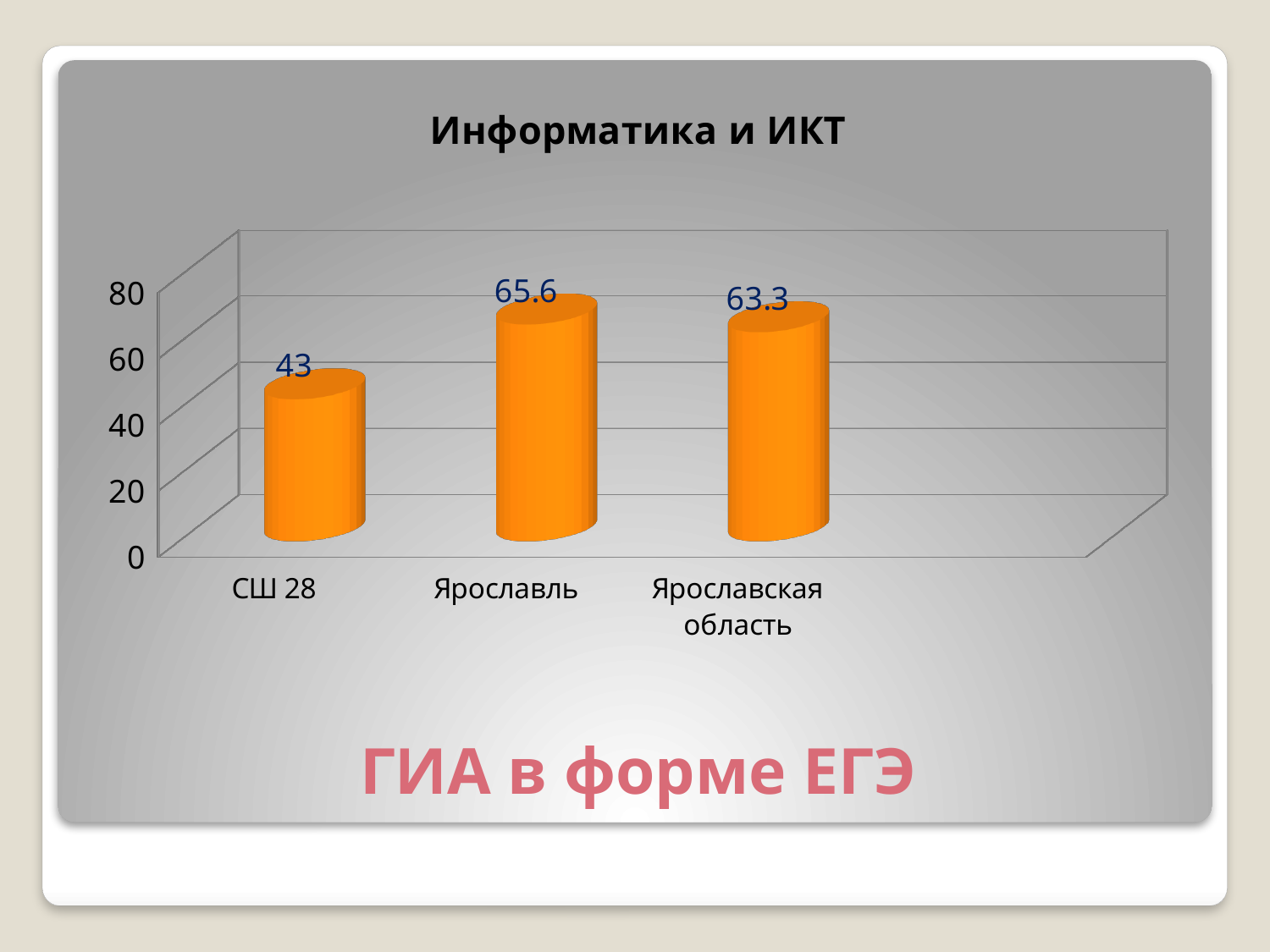
How many categories are shown on the x axis? 3 What is the difference between the values for Ярославль and Ярославская область? 2.3 Is the value for СШ 28 greater or less than 60? less What is the value for Ярославская область? 63.3 What is the value for Ярославль? 65.6 What is the value for СШ 28? 43 What kind of chart is shown on the slide? bar chart Which is larger, the value for Ярославская область or the value for СШ 28? Ярославская область What is the difference between the values for Ярославль and СШ 28? 22.6 What is the title of the chart? Информатика и ИКТ Which category has the highest value? Ярославль Which category has the lowest value? СШ 28